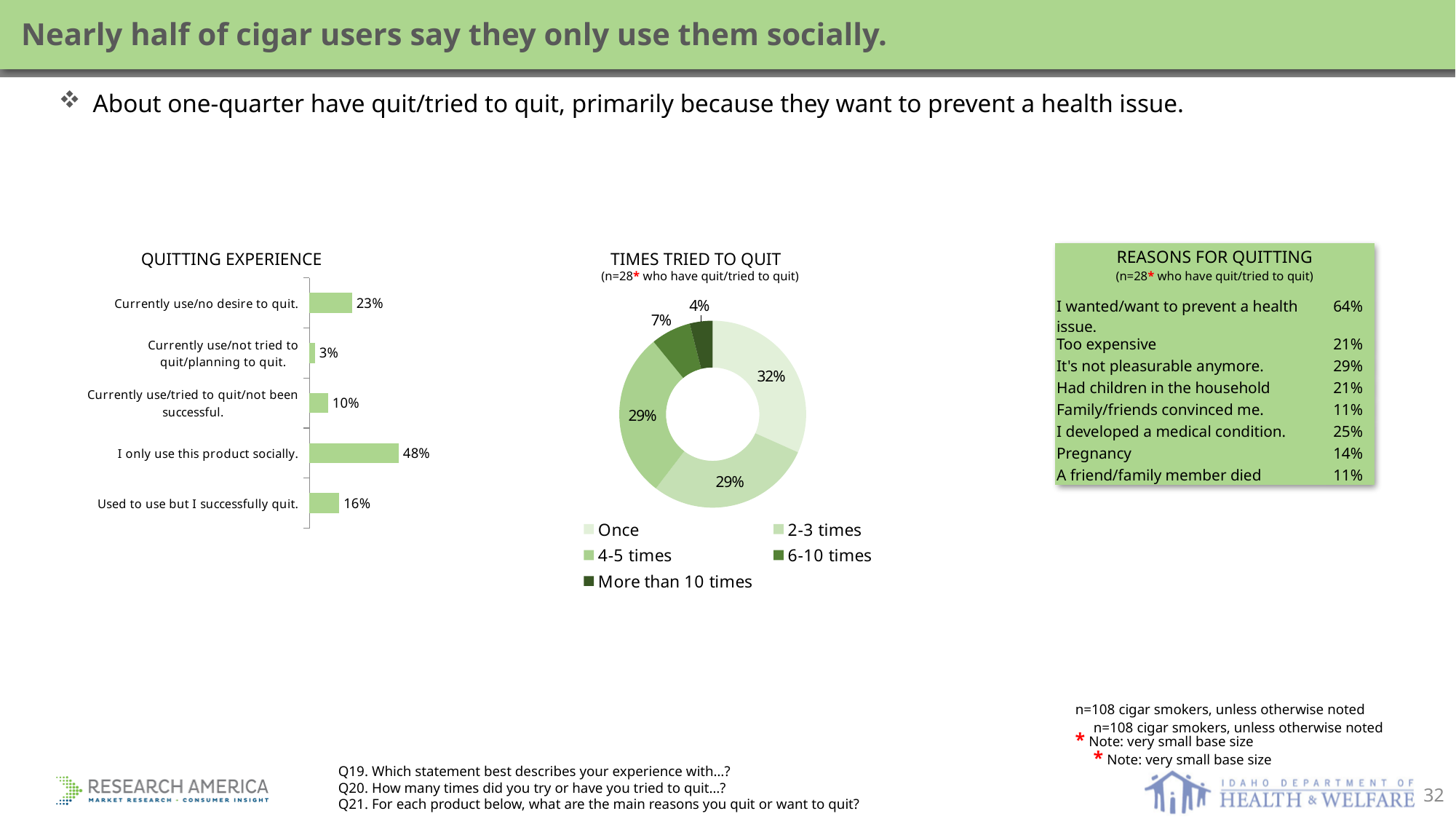
In the QUITTING EXPERIENCE chart, which statement has the lowest percentage? Currently use/not tried to quit/planning to quit. In the QUITTING EXPERIENCE chart, which statement has the highest percentage? I only use this product socially. In the TIMES TRIED TO QUIT chart, what percentage tried to quit 6-10 times? 7% In the QUITTING EXPERIENCE chart, what is the difference between 'Currently use/no desire to quit.' and 'Currently use/tried to quit/not been successful.'? 13% What type of chart is the QUITTING EXPERIENCE chart? Bar chart In the QUITTING EXPERIENCE chart, what percentage say 'Used to use but I successfully quit.'? 16% How many categories does the legend of the TIMES TRIED TO QUIT chart list? 5 In the QUITTING EXPERIENCE chart, how many statements are shown? 5 In the TIMES TRIED TO QUIT chart, which is larger: 'Once' or '6-10 times'? Once In the QUITTING EXPERIENCE chart, what percentage say 'I only use this product socially.'? 48% In the TIMES TRIED TO QUIT chart, which category has the smallest share? More than 10 times In the TIMES TRIED TO QUIT chart, what share of respondents tried to quit once? 32%